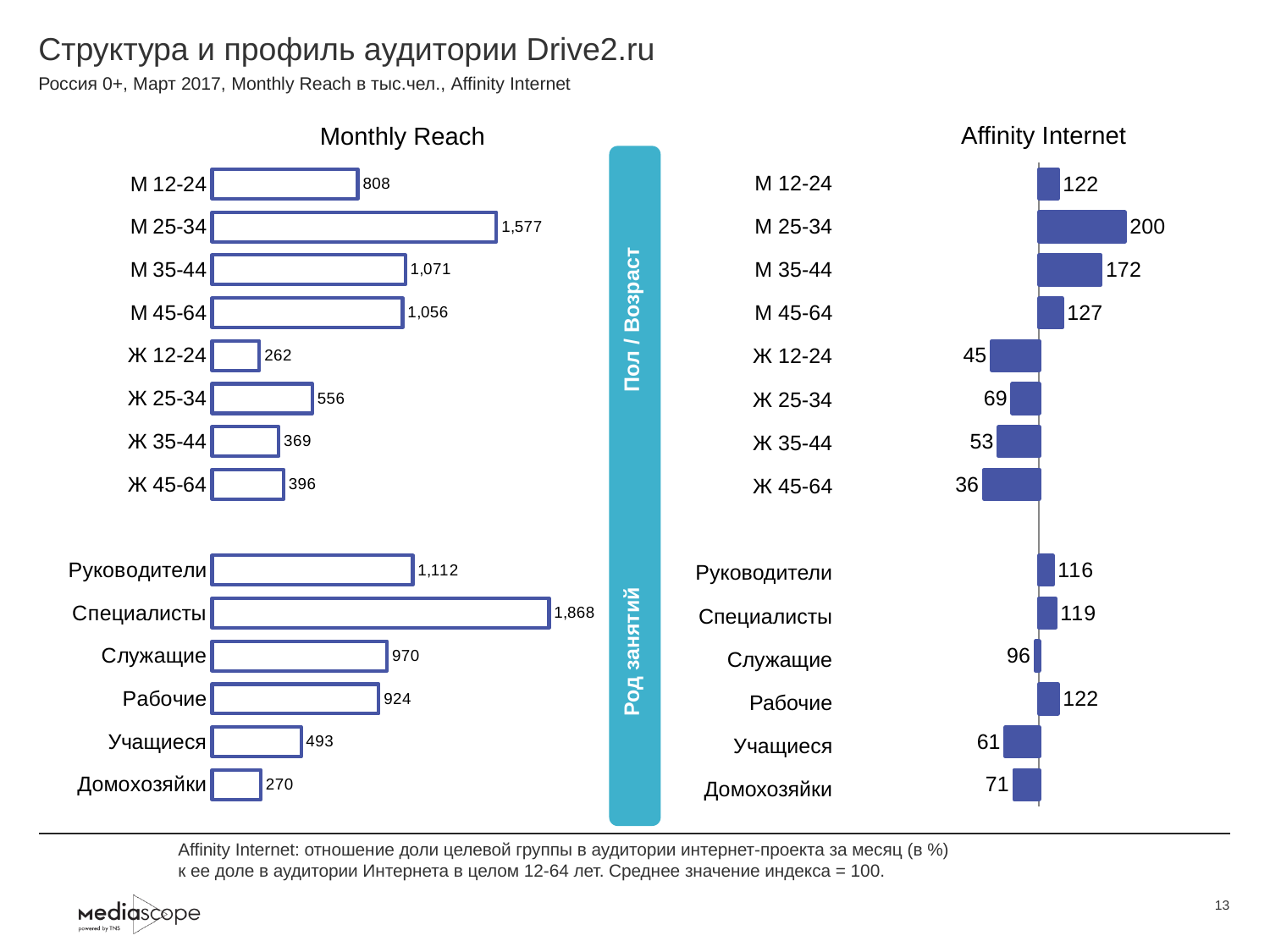
In the Monthly Reach chart, which is larger: Ж 35-44 or Ж 45-64? Ж 45-64 In the Affinity Internet chart, what is the value for Ж 12-24? 45 In the Monthly Reach chart, which category has the highest value? Специалисты In the Monthly Reach chart, what is the difference between М 25-34 and М 12-24? 769 In the Affinity Internet chart, which category has the lowest value? Ж 45-64 In the Affinity Internet chart, what is the value for Рабочие? 122 In the Affinity Internet chart, which is larger: М 35-44 or М 45-64? М 35-44 How many categories are shown in the Monthly Reach chart? 14 In the Monthly Reach chart, what is the value for Домохозяйки? 270 In the Affinity Internet chart, what is the difference between Специалисты and Служащие? 23 In the Monthly Reach chart, what is the value for М 25-34? 1,577 What kind of chart is the Affinity Internet chart? bar chart